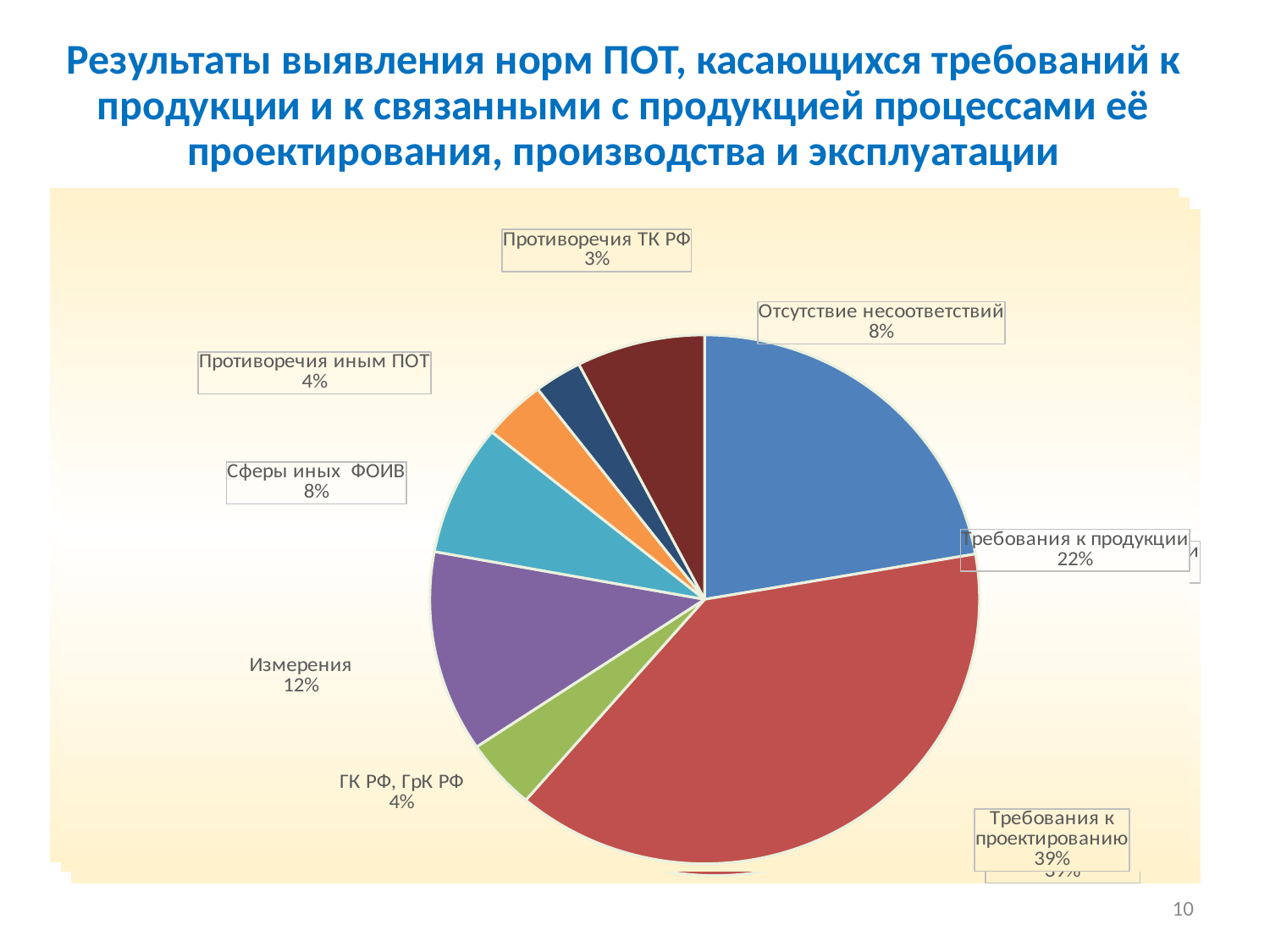
How many slices does the pie chart have? 8 Which is larger: the share for "Измерения" or the share for "Сферы иных ФОИВ"? Измерения What colour is the slice for "Требования к проектированию"? red What share of the pie does "Требования к проектированию" have? 39% Which slice of the pie is the smallest? Противоречия ТК РФ What is the difference between the shares of "Требования к проектированию" and "Требования к продукции"? 17% What is the value shown for "Противоречия ТК РФ"? 3% Which slice of the pie is the largest? Требования к проектированию What is the value shown for "Измерения"? 12% What kind of chart is shown on the slide? pie chart What share of the pie does "Требования к продукции" have? 22% What is the value shown for "Сферы иных ФОИВ"? 8%